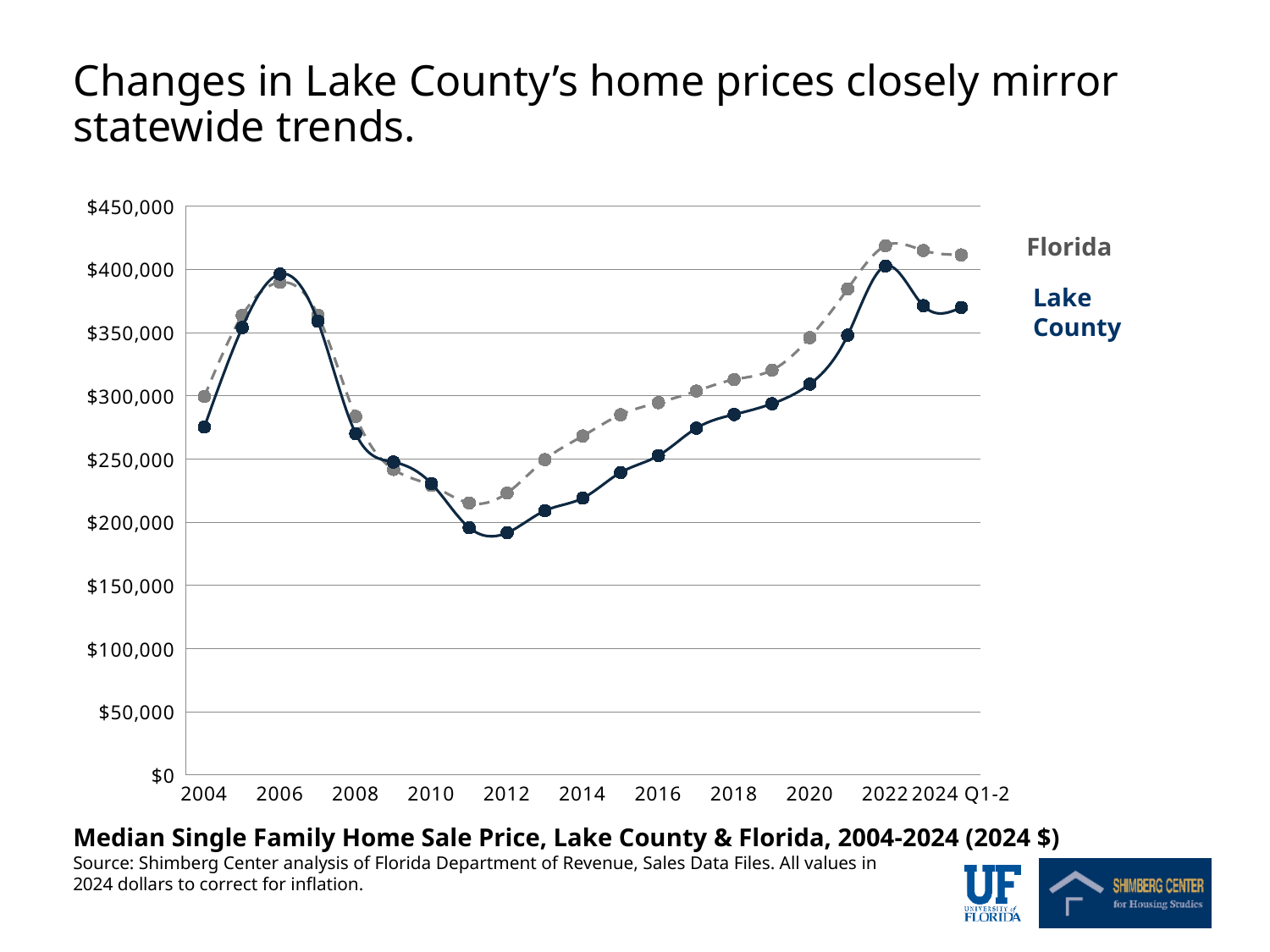
How many yearly data points does each series have? 21 What kind of chart is shown on the slide? Line chart Which series is drawn with the gray dashed line? Florida Is the Florida value for 2022 greater or less than $400,000? greater Do Lake County home prices rise or fall between 2012 and 2022? Rise Is the Lake County value for 2024 Q1-2 greater or less than $350,000? greater In which year does the Florida series reach its highest value? 2022 What is the title of the chart? Median Single Family Home Sale Price, Lake County & Florida, 2004-2024 (2024 $) Is the Lake County value for 2004 greater or less than $250,000? greater In 2020, which series has the higher value, Florida or Lake County? Florida How many series does the chart show? 2